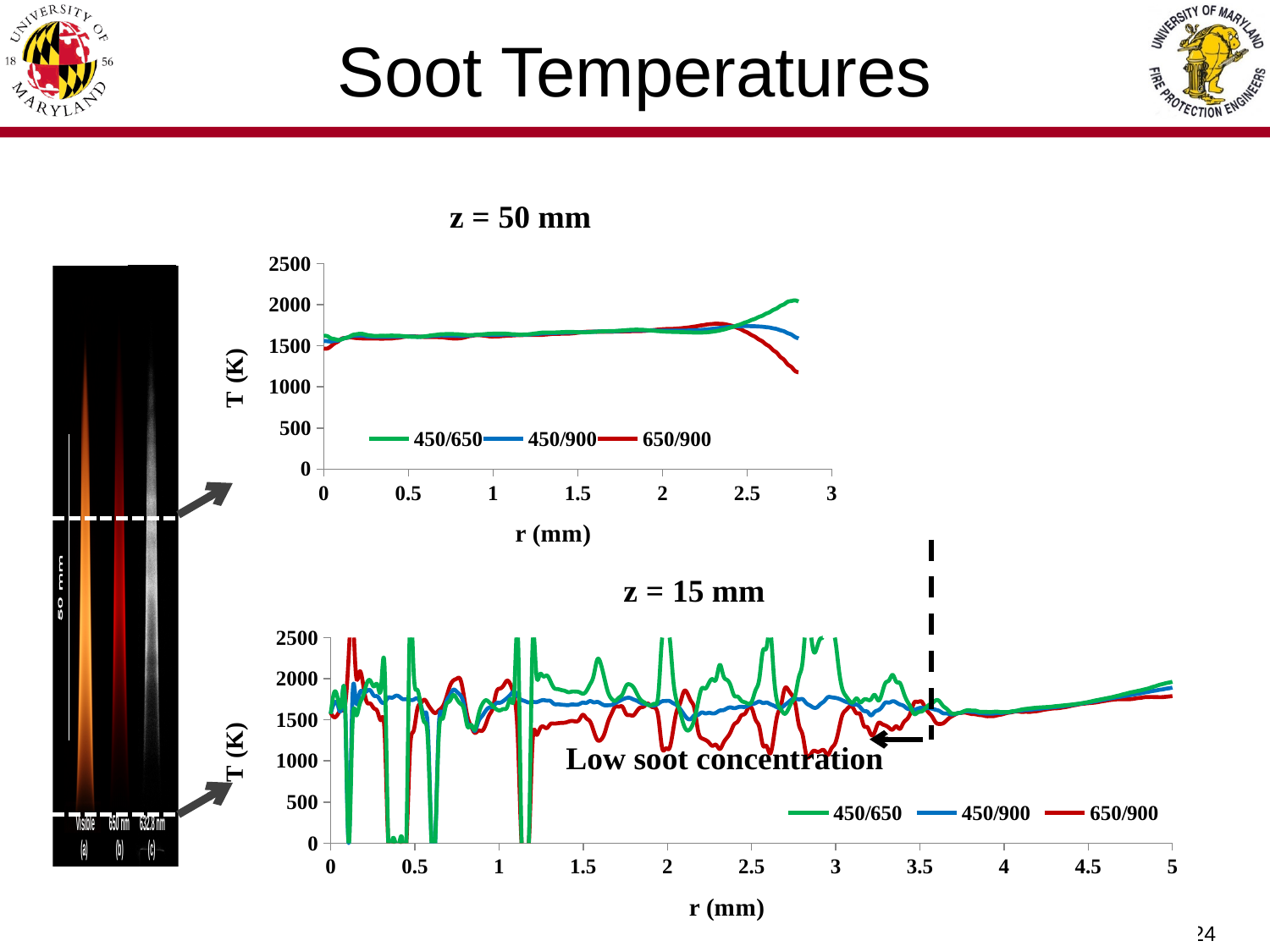
What kind of chart is the "z = 50 mm" chart? line chart What are the legend entries on the "z = 50 mm" chart? 450/650, 450/900, 650/900 In the "z = 50 mm" chart, is the value of the 450/900 series at r = 0 mm greater or less than 1000? greater How many series does the legend of the "z = 15 mm" chart list? 3 What kind of chart is the "z = 15 mm" chart? line chart What text annotation is written inside the "z = 15 mm" chart? Low soot concentration In the "z = 50 mm" chart, is the value of the 450/650 series at r = 2.8 mm greater or less than 1500? greater In the "z = 50 mm" chart, is the value of the 650/900 series at r = 2.8 mm greater or less than 1500? less In the "z = 15 mm" chart, do the values of the 450/650 series rise or fall between r = 4 mm and r = 5 mm? rise In the "z = 50 mm" chart, at r = 2.8 mm, which series has the larger value, 450/650 or 650/900? 450/650